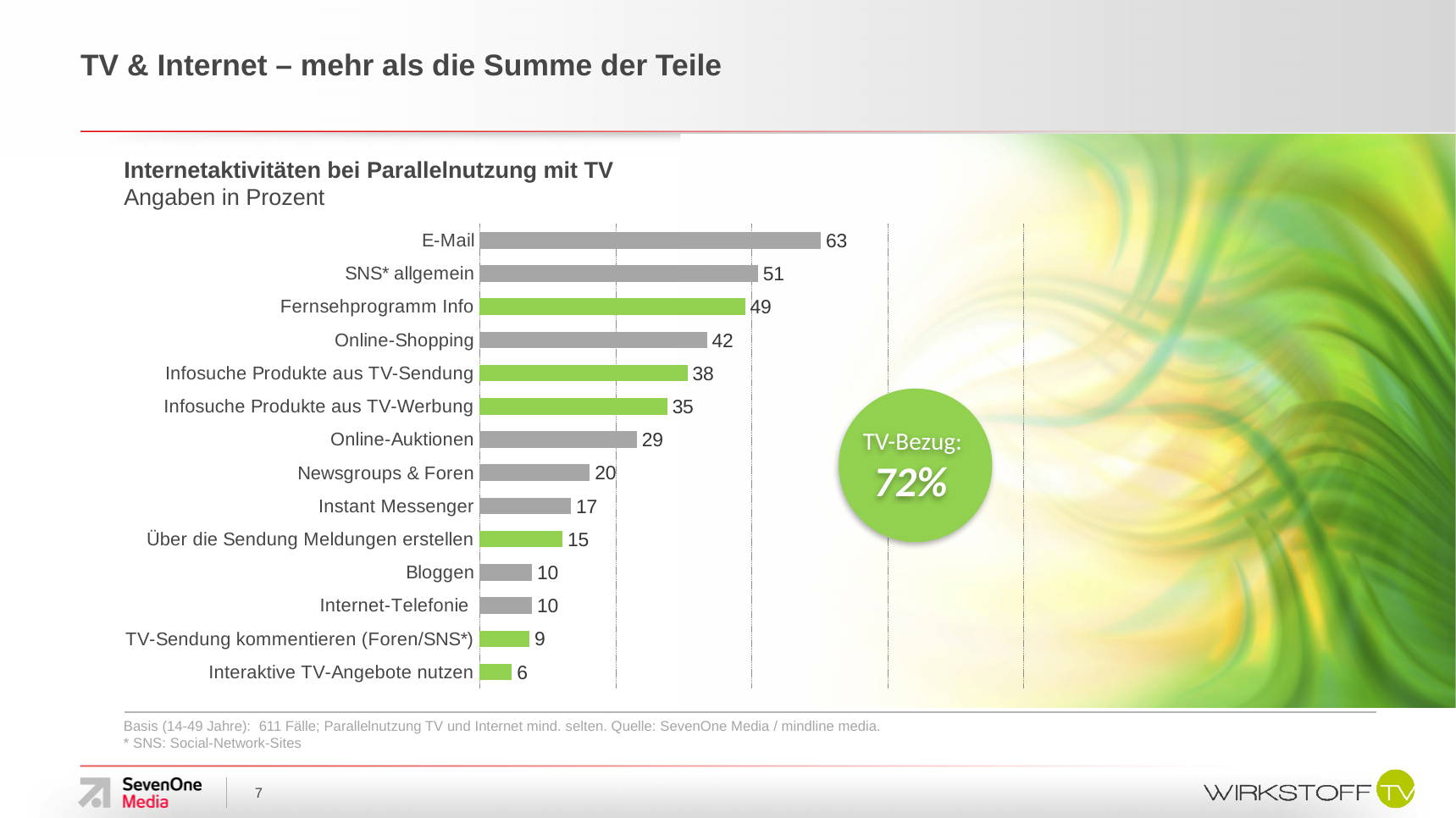
How many categories are shown in the chart? 14 What percentage is shown in the green circle labelled TV-Bezug? 72% What is the value for Interaktive TV-Angebote nutzen? 6 Which category has the lowest value? Interaktive TV-Angebote nutzen What is the value for E-Mail? 63 Which is larger, the value for Online-Shopping or the value for Fernsehprogramm Info? Fernsehprogramm Info What is the value for Online-Auktionen? 29 Which category has the highest value? E-Mail What is the difference between the values for E-Mail and SNS* allgemein? 12 What kind of chart is shown on the slide? Bar chart What is the value for Fernsehprogramm Info? 49 What is the difference between the values for Infosuche Produkte aus TV-Sendung and Infosuche Produkte aus TV-Werbung? 3